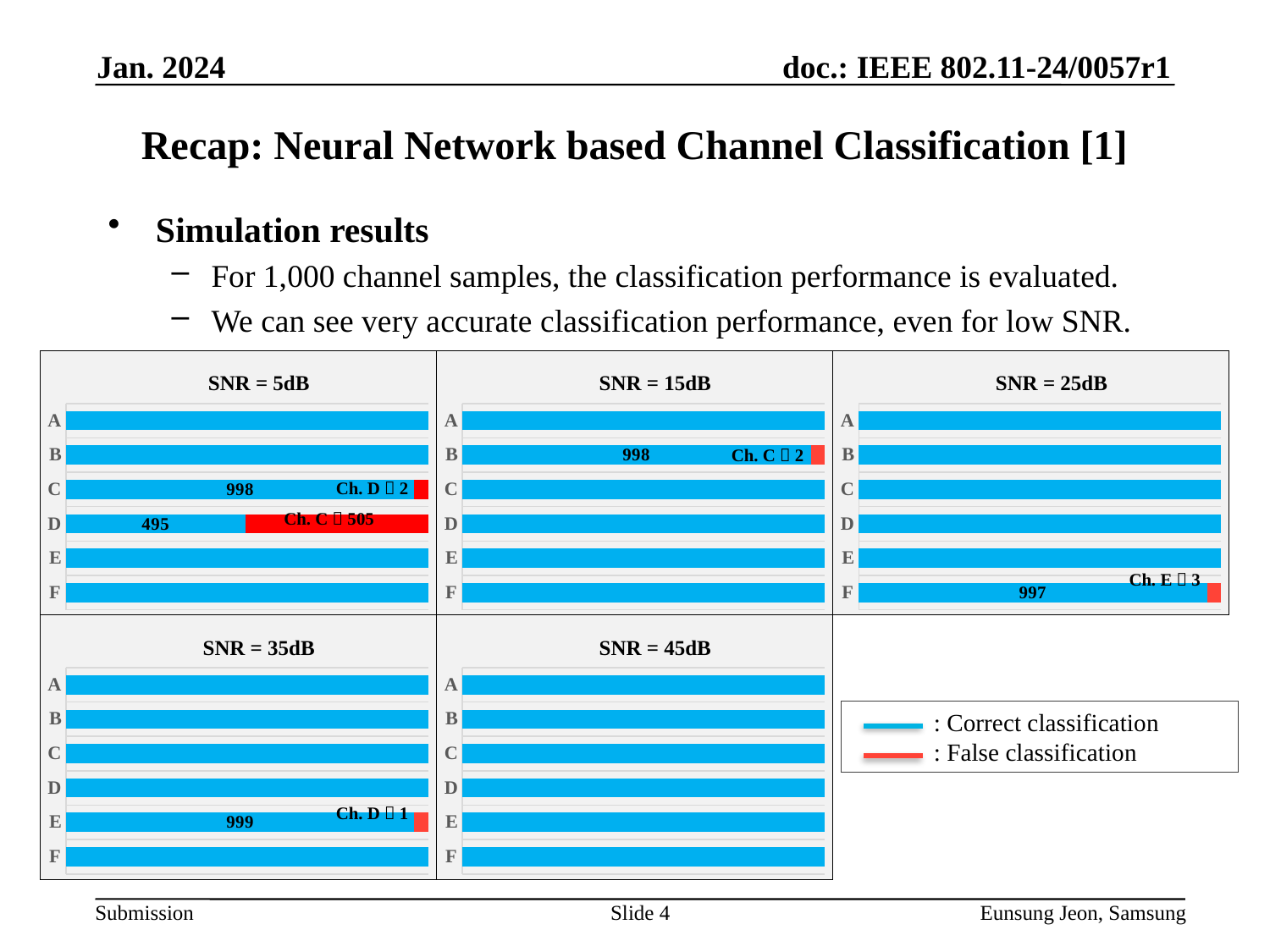
How many channel categories are shown in the SNR = 45dB chart? 6 In the SNR = 5dB chart, what is the difference between the correct classification counts for channel C and channel D? 503 In the SNR = 5dB chart, which channel has the lowest number of correct classifications? D In the SNR = 25dB chart, how many samples of channel F were correctly classified? 997 What kind of chart is the SNR = 15dB chart? Bar chart In the SNR = 5dB chart, how many samples of channel C were correctly classified? 998 In the SNR = 5dB chart, how many samples of channel D were correctly classified? 495 In the SNR = 35dB chart, how many samples of channel E were correctly classified? 999 In the SNR = 5dB chart, how many samples of channel D were falsely classified as Ch. C? 505 In the SNR = 5dB chart, which has more correct classifications, channel C or channel D? C In the SNR = 5dB chart, what is the total of the stacked bar for channel D (correct plus false classifications)? 1000 In the SNR = 15dB chart, how many samples of channel B were correctly classified? 998